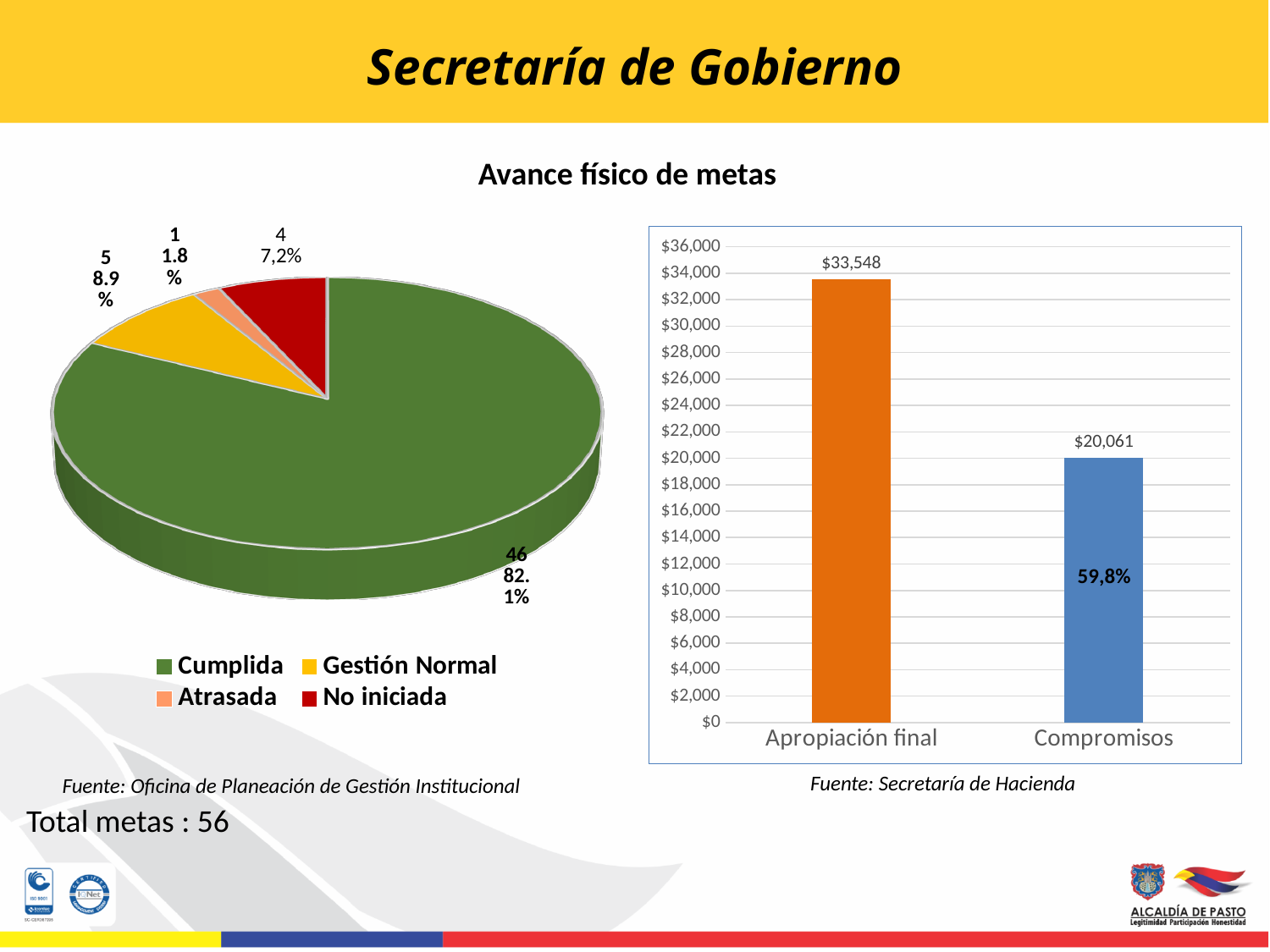
In the pie chart on the left, what percentage is shown for the No iniciada slice? 7,2% In the pie chart on the left, what percentage share does the Cumplida slice show? 82.1% How many categories does the legend of the pie chart on the left list? 4 In the pie chart on the left, how many metas are labelled as Cumplida? 46 What kind of chart is shown on the right side of the slide? Bar chart In the pie chart on the left, which category has the largest slice? Cumplida In the bar chart on the right, what is the value for Apropiación final? $33,548 In the bar chart on the right, what is the value for Compromisos? $20,061 In the pie chart on the left, which category has the smallest slice? Atrasada In the bar chart on the right, which is larger, Apropiación final or Compromisos? Apropiación final In the pie chart on the left, how many metas are in the Gestión Normal category? 5 In the bar chart on the right, what is the difference between Apropiación final and Compromisos? $13,487